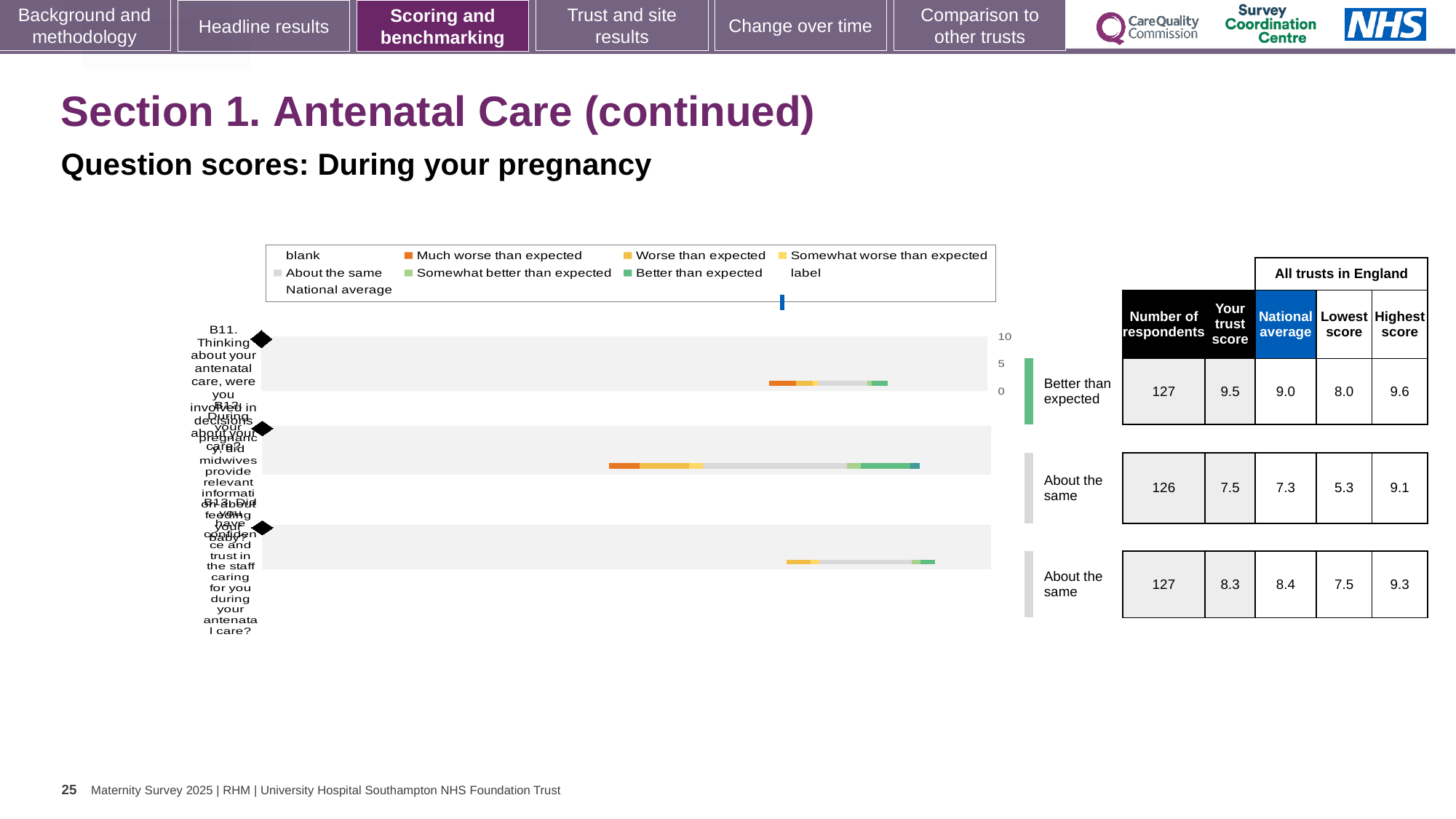
How many question bars (categories) are plotted in the chart? 3 What kind of chart is shown on the slide? bar chart In the table beside the chart, what is the lowest value in the 'Lowest score' column? 5.3 In the table beside the chart, what is the number of respondents for the first row (B11)? 127 What colour represents 'Better than expected' in the chart legend? green In the table beside the chart, for the second row (B12), which is larger: 'Your trust score' or 'National average'? Your trust score In the table beside the chart, what is the difference between 'Your trust score' and 'National average' for the first row (B11)? 0.5 In the table beside the chart, what is 'Your trust score' for the first row (B11)? 9.5 What colour represents 'Much worse than expected' in the chart legend? orange In the table beside the chart, which row has the highest 'Your trust score'? the first row (B11), 9.5 How many entries does the chart legend list? 9 In the table beside the chart, what is the 'Highest score' for the third row (B13)? 9.3